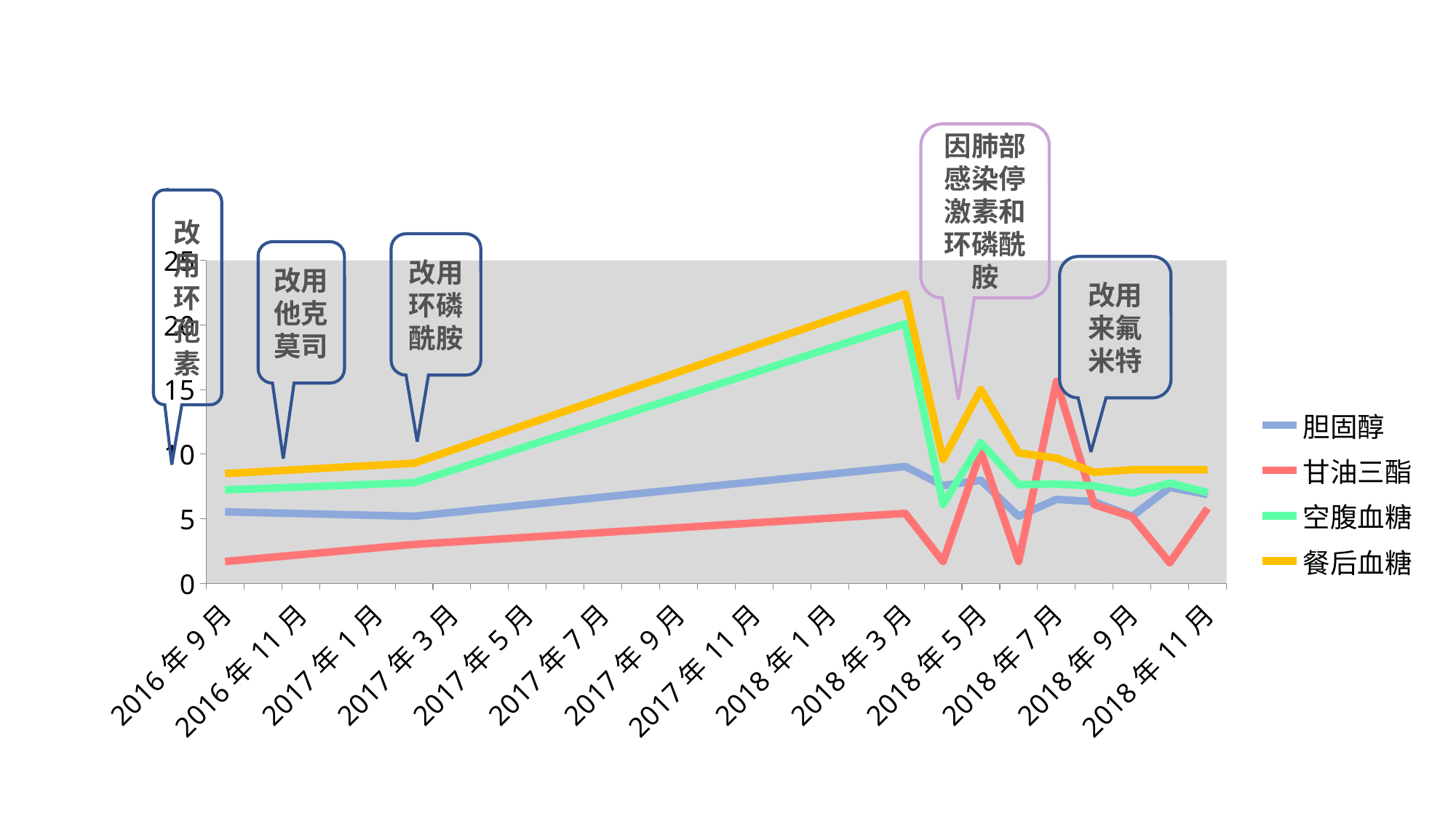
Which series has the lowest value at 2016年9月? 甘油三酯 What kind of chart is shown on the slide? line chart Is the value of 胆固醇 at 2018年3月 greater or less than 10? less Is the value of 餐后血糖 at 2018年3月 greater or less than 20? greater What does the callout pointing near 2018年9月 say? 改用来氟米特 Does 餐后血糖 rise or fall between 2017年3月 and 2018年3月? rise Is the value of 甘油三酯 at 2016年9月 greater or less than 5? less How many time points are labelled on the x axis? 14 What colour is the 甘油三酯 line in the legend? red Which series has the highest value at 2018年3月? 餐后血糖 How many series does the legend list? 4 At 2018年7月, which is larger: 甘油三酯 or 胆固醇? 甘油三酯